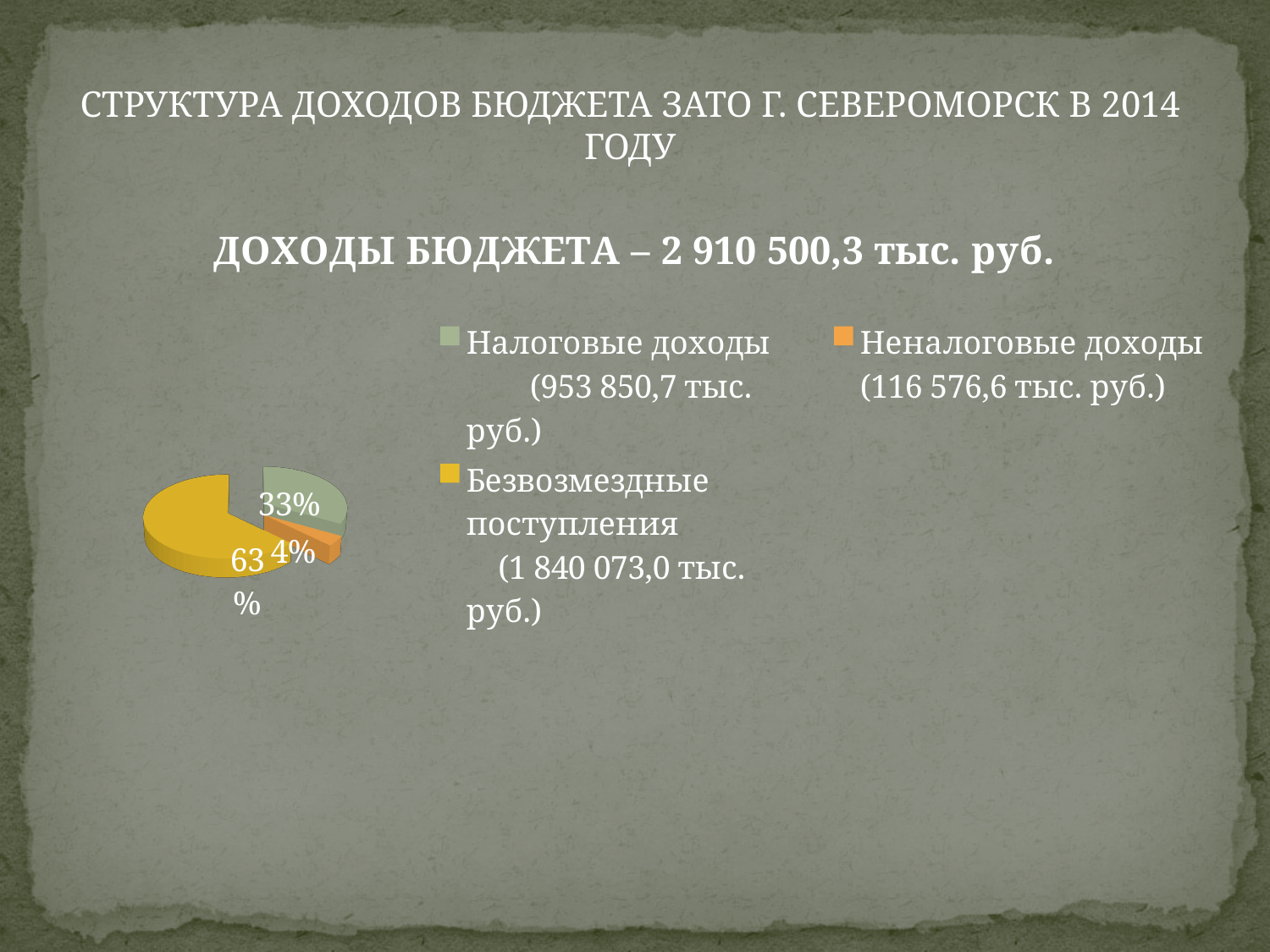
What share of the pie does Налоговые доходы represent? 33% Which category has the smallest slice of the pie? Неналоговые доходы What share of the pie does Безвозмездные поступления represent? 63% How many slices does the pie chart have? 3 What amount is given in the legend for Налоговые доходы? 953 850,7 тыс. руб. What is the difference in percentage points between the Безвозмездные поступления slice and the Налоговые доходы slice? 30 What share of the pie does Неналоговые доходы represent? 4% How many entries does the legend of the pie chart list? 3 Which slice is larger: Налоговые доходы or Неналоговые доходы? Налоговые доходы What colour is the Безвозмездные поступления slice in the pie chart? yellow Which category has the largest slice of the pie? Безвозмездные поступления What kind of chart is shown on the slide? pie chart